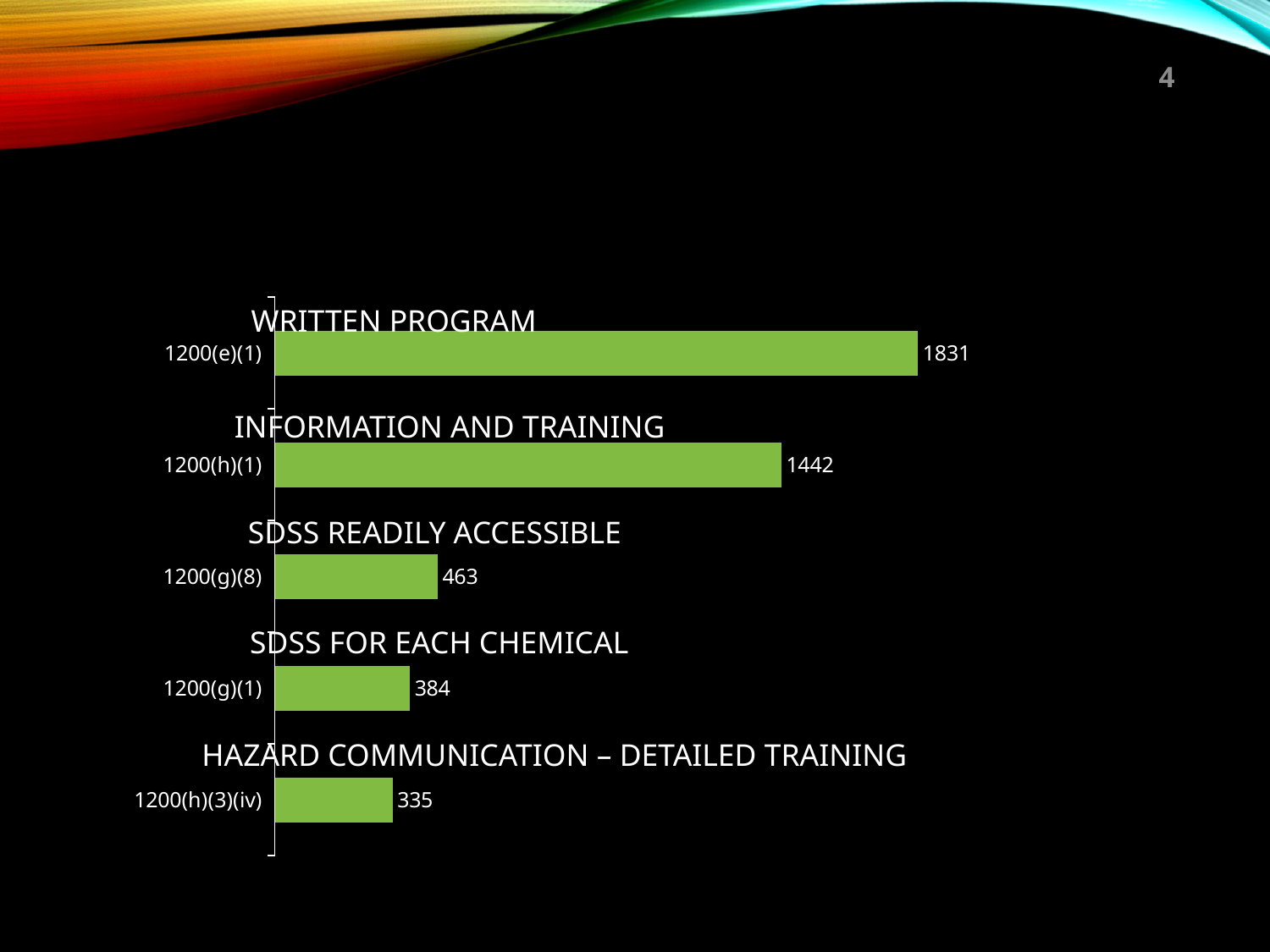
What is the value for 1200(g)(1)? 384 What is the value for 1200(e)(1)? 1831 What is the value for 1200(g)(8)? 463 Which category has the lowest value? 1200(h)(3)(iv) What is the value for 1200(h)(1)? 1442 What kind of chart is shown on the slide? Bar chart What is the difference between the values for 1200(e)(1) and 1200(h)(1)? 389 Which is larger, the value for 1200(g)(1) or the value for 1200(h)(3)(iv)? 1200(g)(1) What is the value for 1200(h)(3)(iv)? 335 What is the difference between the values for 1200(g)(8) and 1200(g)(1)? 79 Which category has the highest value? 1200(e)(1) How many categories are shown in the chart? 5